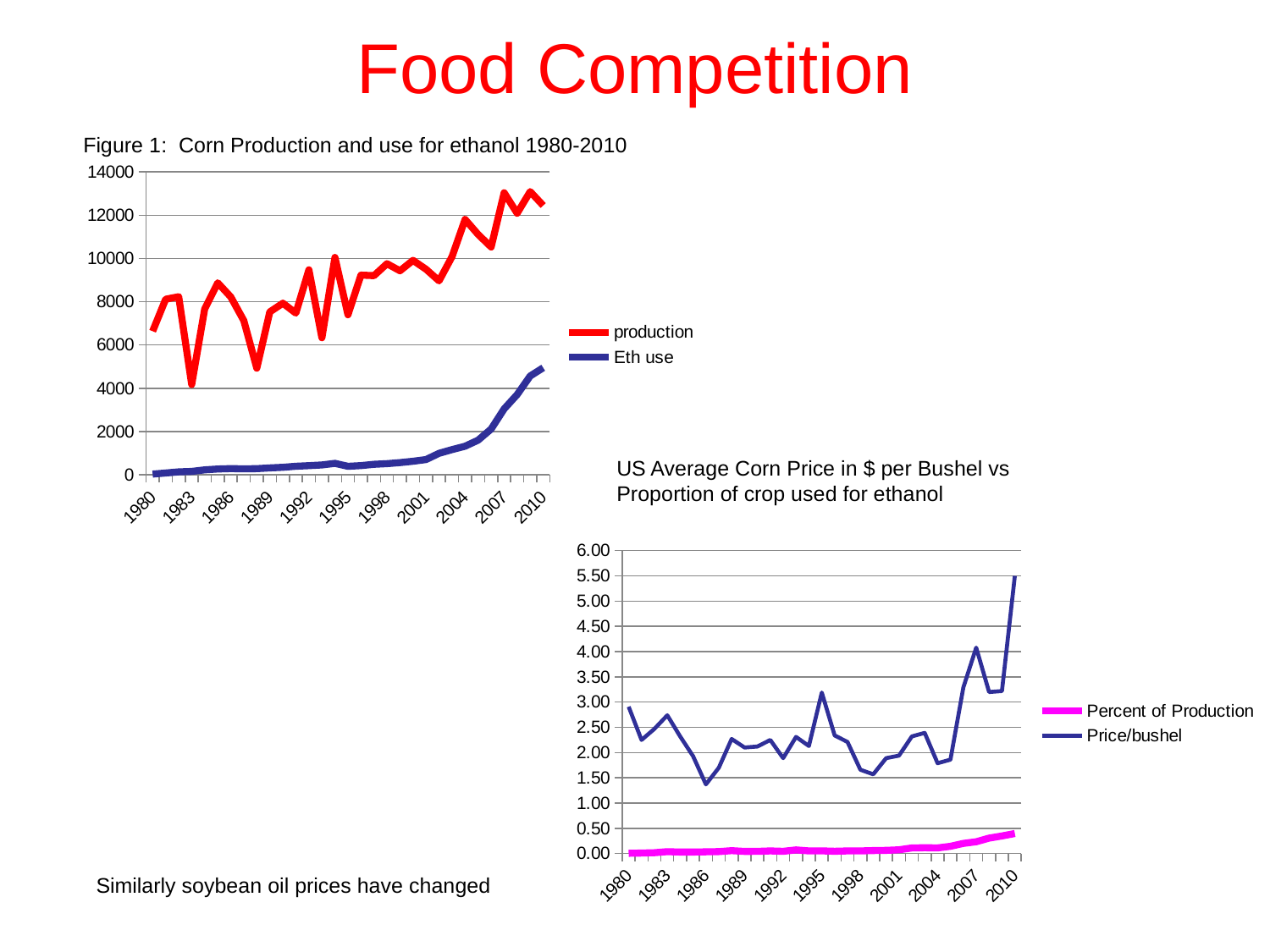
In Figure 1: Corn Production and use for ethanol 1980-2010, does the Eth use series generally rise or fall from 1980 to 2010? rise How many series does the legend of Figure 1: Corn Production and use for ethanol 1980-2010 list? 2 In Figure 1: Corn Production and use for ethanol 1980-2010, which series has the larger value in 2010, production or Eth use? production What kind of chart is Figure 1: Corn Production and use for ethanol 1980-2010? line chart How many series does the legend of the chart titled US Average Corn Price in $ per Bushel vs Proportion of crop used for ethanol list? 2 In the chart titled US Average Corn Price in $ per Bushel vs Proportion of crop used for ethanol, is the Price/bushel value for 1986 greater or less than 2.00? less In Figure 1: Corn Production and use for ethanol 1980-2010, what colour is the production line? red In Figure 1: Corn Production and use for ethanol 1980-2010, is the Eth use value for 2010 greater or less than 4000? greater In Figure 1: Corn Production and use for ethanol 1980-2010, is the Eth use value for 2001 greater or less than 2000? less In the chart titled US Average Corn Price in $ per Bushel vs Proportion of crop used for ethanol, which year has the larger Price/bushel value, 1986 or 2010? 2010